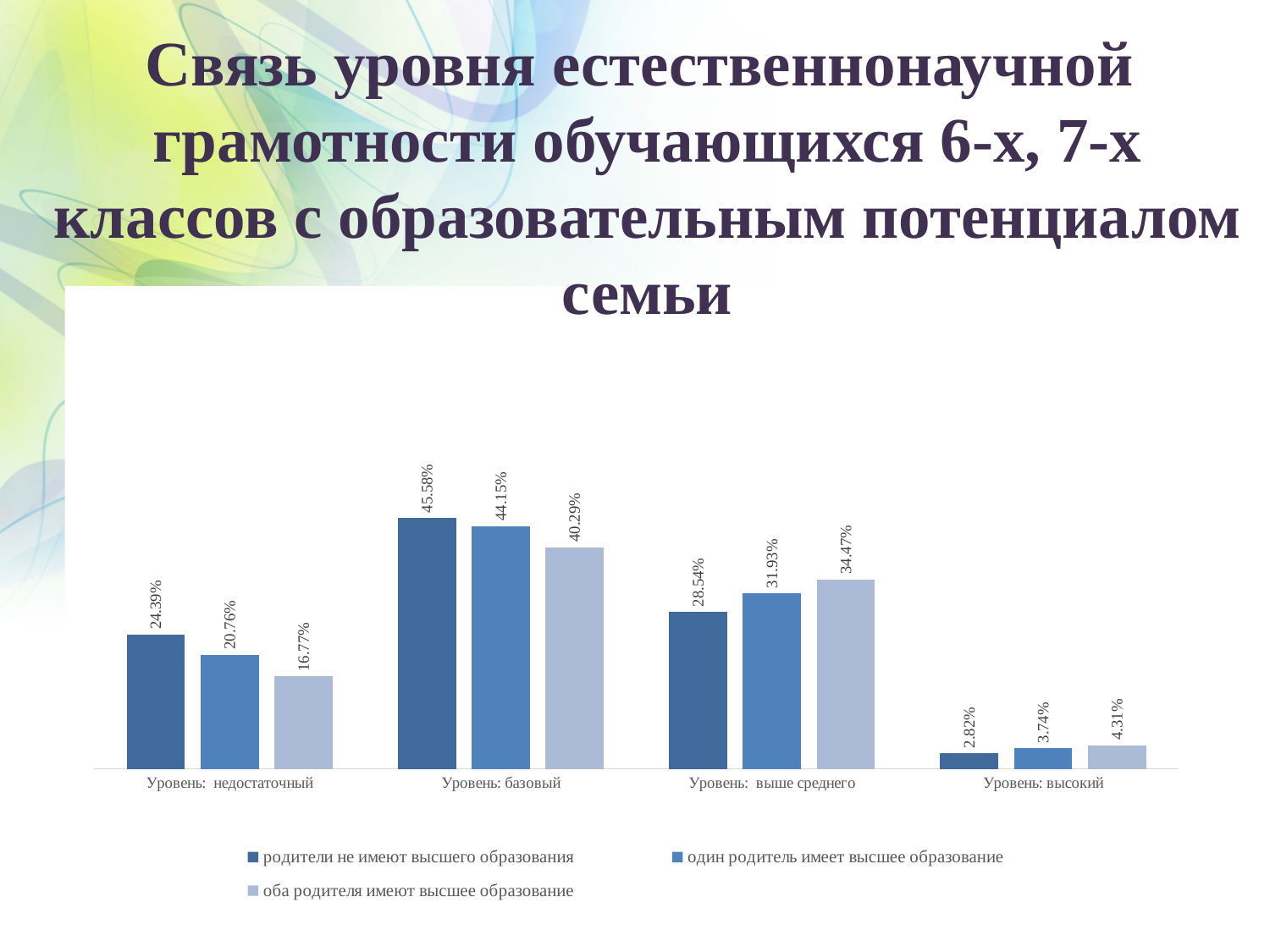
What is the value for "родители не имеют высшего образования" at "Уровень: базовый"? 45.58% Which category has the highest value for the series "родители не имеют высшего образования"? Уровень: базовый What is the value for "оба родителя имеют высшее образование" at "Уровень: выше среднего"? 34.47% How many series does the legend list? 3 What is the value for "один родитель имеет высшее образование" at "Уровень: высокий"? 3.74% Which legend entry corresponds to the lightest-coloured bars? оба родителя имеют высшее образование How many categories are shown on the x axis? 4 Which category has the lowest value for the series "оба родителя имеют высшее образование"? Уровень: высокий What is the value for "оба родителя имеют высшее образование" at "Уровень: недостаточный"? 16.77% What kind of chart is shown on the slide? Bar chart What is the difference between "родители не имеют высшего образования" and "оба родителя имеют высшее образование" at "Уровень: недостаточный"? 7.62% At "Уровень: выше среднего", which is larger: "родители не имеют высшего образования" or "оба родителя имеют высшее образование"? оба родителя имеют высшее образование